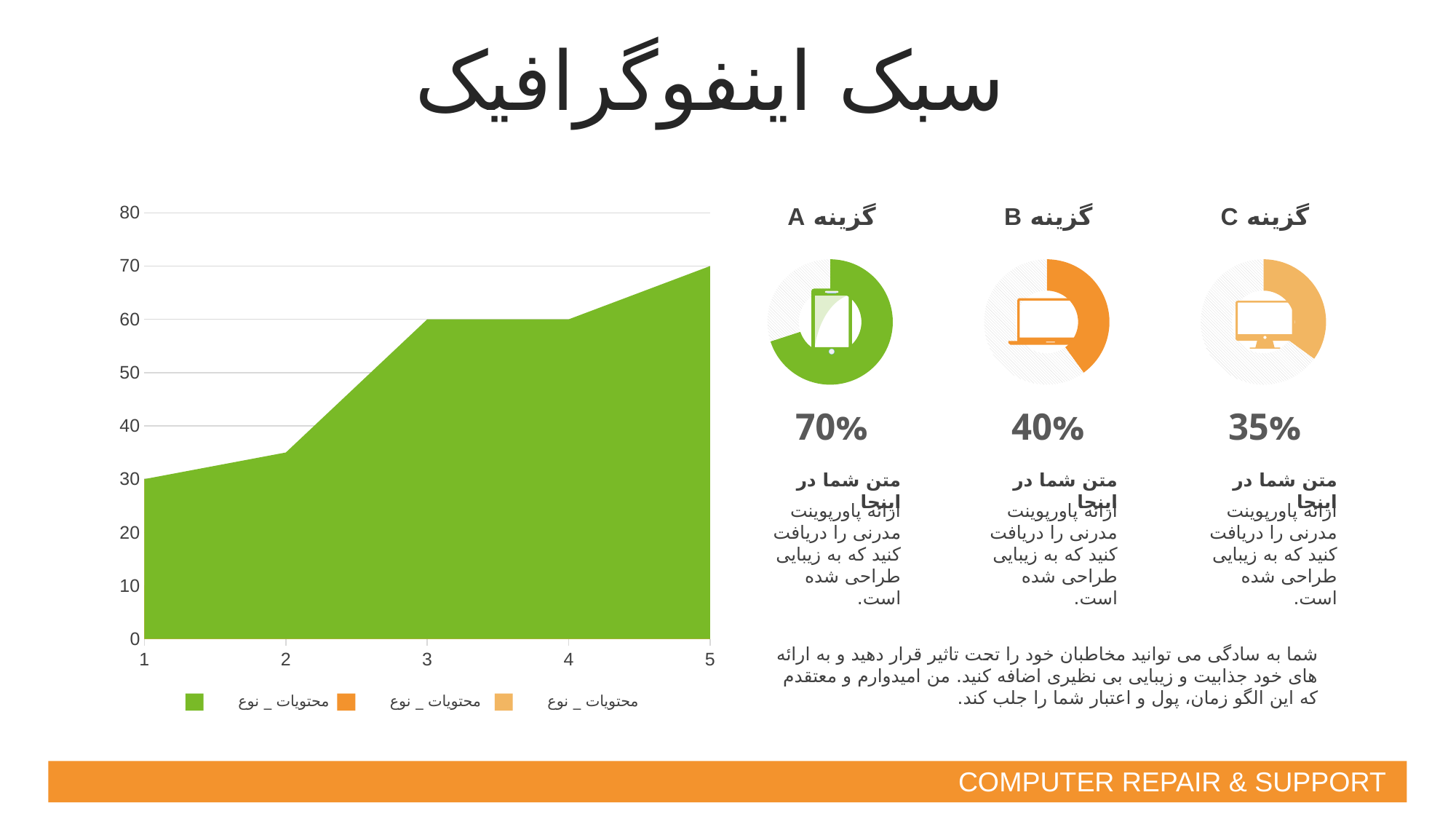
In the area chart, what is the value at x = 3? 60 In the area chart, what is the difference between the value at x = 5 and the value at x = 1? 40 What kind of chart is shown on the left of the slide? area chart In the area chart, at which x value is the plotted value highest? 5 In the area chart, what is the value at x = 5? 70 How many entries does the legend of the area chart list? 3 How many points are plotted along the x axis of the area chart? 5 In the area chart, do the values generally rise or fall from x = 1 to x = 5? rise In the area chart, at which x value is the plotted value lowest? 1 What colour is the filled area in the area chart? green In the area chart, is the value at x = 2 greater or less than 40? less In the area chart, what is the value at x = 1? 30